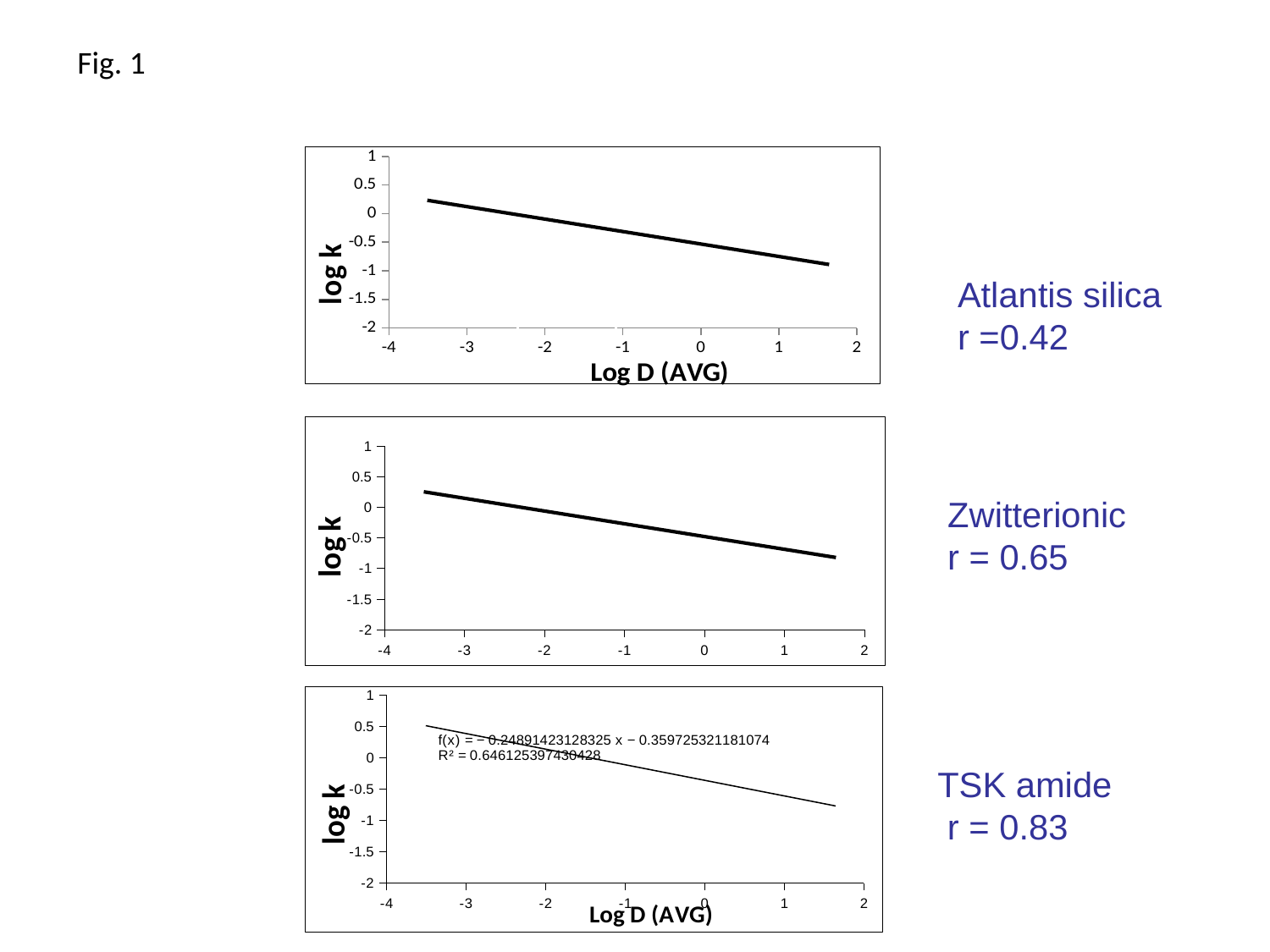
What is the y-axis label of the top chart (Atlantis silica)? log k In the top chart (Atlantis silica), is the value of log k at Log D (AVG) = 0 greater or less than 0? less In the middle chart (Zwitterionic), do the log k values rise or fall along the x axis? fall What R² value is printed on the bottom chart (TSK amide)? 0.646125397430428 In the bottom chart (TSK amide), is the value of log k at Log D (AVG) = 1 greater or less than -0.5? less In the middle chart (Zwitterionic), is the value of log k at Log D (AVG) = -3 greater or less than 0? greater What is the x-axis label of the bottom chart (TSK amide)? Log D (AVG) In the top chart (Atlantis silica), do the log k values rise or fall as Log D (AVG) increases? fall How many charts are shown on the slide? 3 What is the slope of the fitted line f(x) printed on the bottom chart (TSK amide)? −0.24891423128325 What kind of chart is the top chart labelled Atlantis silica? line chart In the bottom chart (TSK amide), do the log k values rise or fall as Log D (AVG) increases? fall